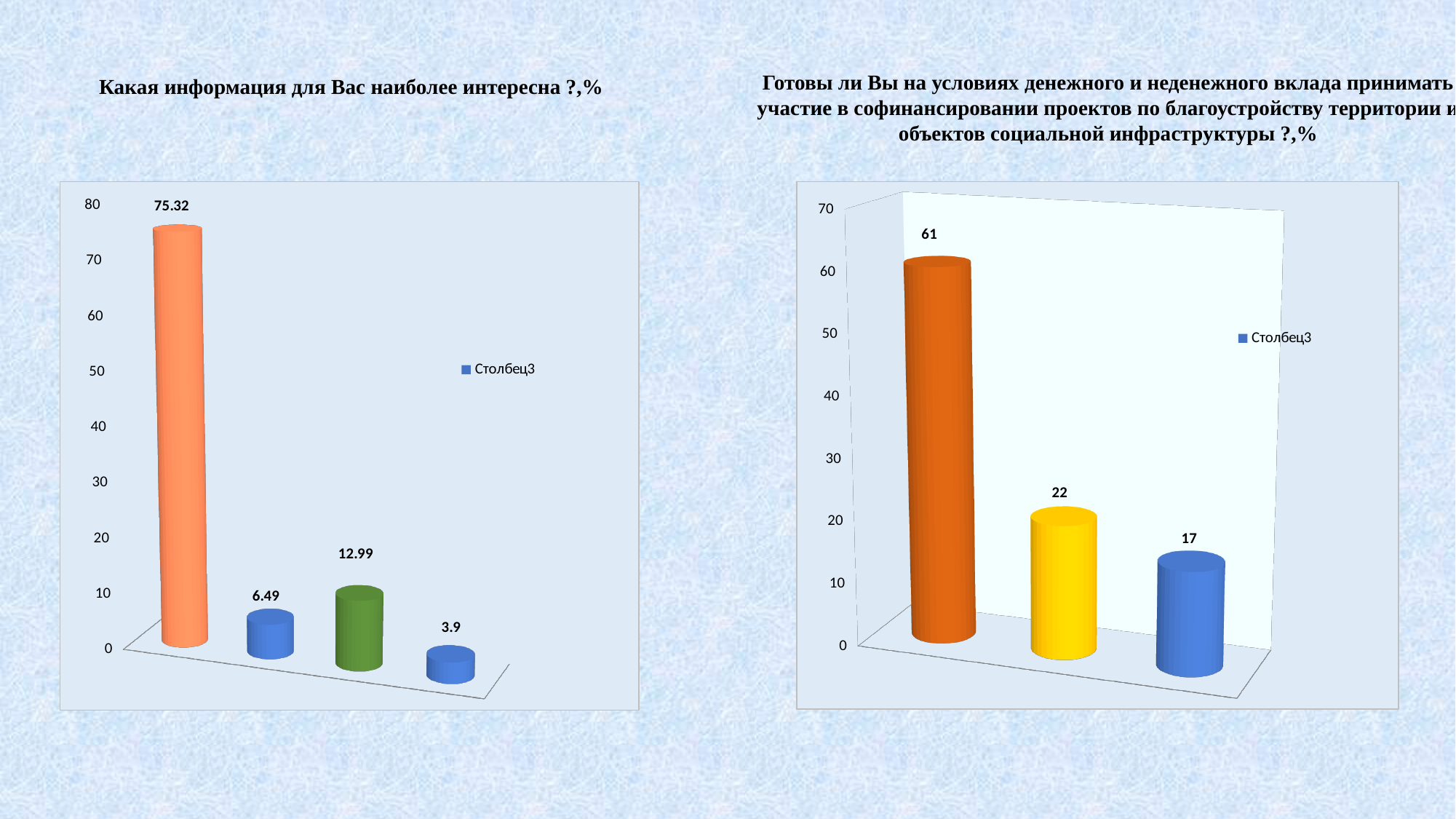
In the right chart about co-financing projects, how many bars are plotted? 3 What is the legend entry shown in the left chart? Столбец3 In the left chart titled "Какая информация для Вас наиболее интересна ?,%", how many bars are plotted? 4 In the left chart titled "Какая информация для Вас наиболее интересна ?,%", which is larger: the second bar or the third bar? the third bar (12.99) In the left chart titled "Какая информация для Вас наиболее интересна ?,%", what is the value of the shortest bar? 3.9 In the right chart about co-financing projects, what is the value of the lowest bar? 17 What type of chart is shown on the right side of the slide? bar chart In the left chart titled "Какая информация для Вас наиболее интересна ?,%", what is the value of the green bar? 12.99 In the left chart titled "Какая информация для Вас наиболее интересна ?,%", what is the difference between the first bar (75.32) and the third bar (12.99)? 62.33 In the left chart titled "Какая информация для Вас наиболее интересна ?,%", what is the value of the tallest bar? 75.32 In the right chart about co-financing projects, what is the difference between the yellow bar (22) and the blue bar (17)? 5 In the right chart about co-financing projects, what is the value of the orange bar? 61